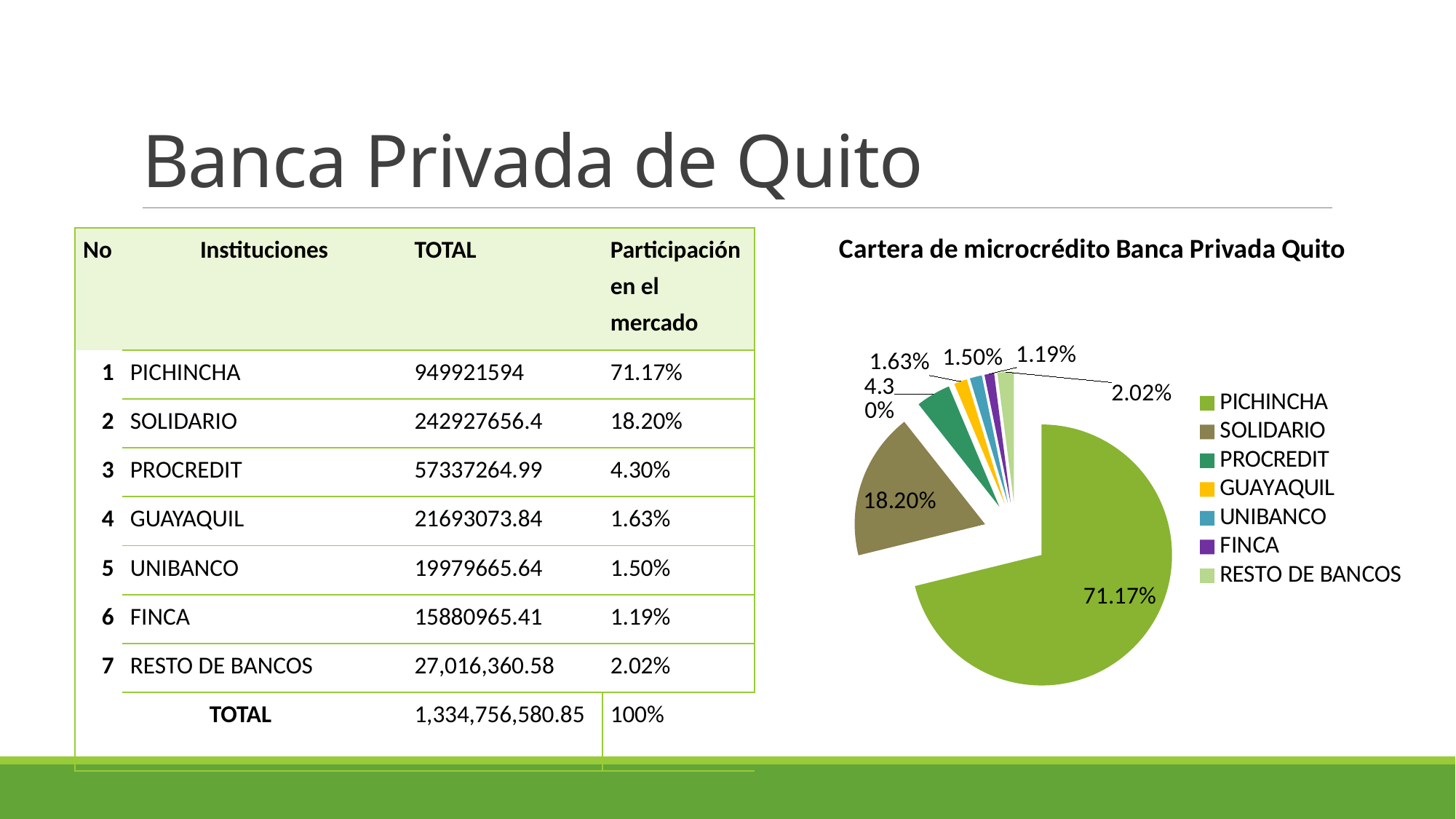
What is the title of the chart? Cartera de microcrédito Banca Privada Quito What is the value shown for GUAYAQUIL in the chart? 1.63% Which institution has the smallest slice of the pie? FINCA Which institution has the largest slice of the pie? PICHINCHA What share of the pie does PICHINCHA hold? 71.17% What is the value shown for PROCREDIT in the chart? 4.30% What type of chart is shown on the slide? pie chart How many entries does the chart legend list? 7 What share of the pie does SOLIDARIO hold? 18.20% What is the value shown for RESTO DE BANCOS in the chart? 2.02% What is the difference between the shares of PICHINCHA and SOLIDARIO? 52.97% Which has a larger share, UNIBANCO or FINCA? UNIBANCO